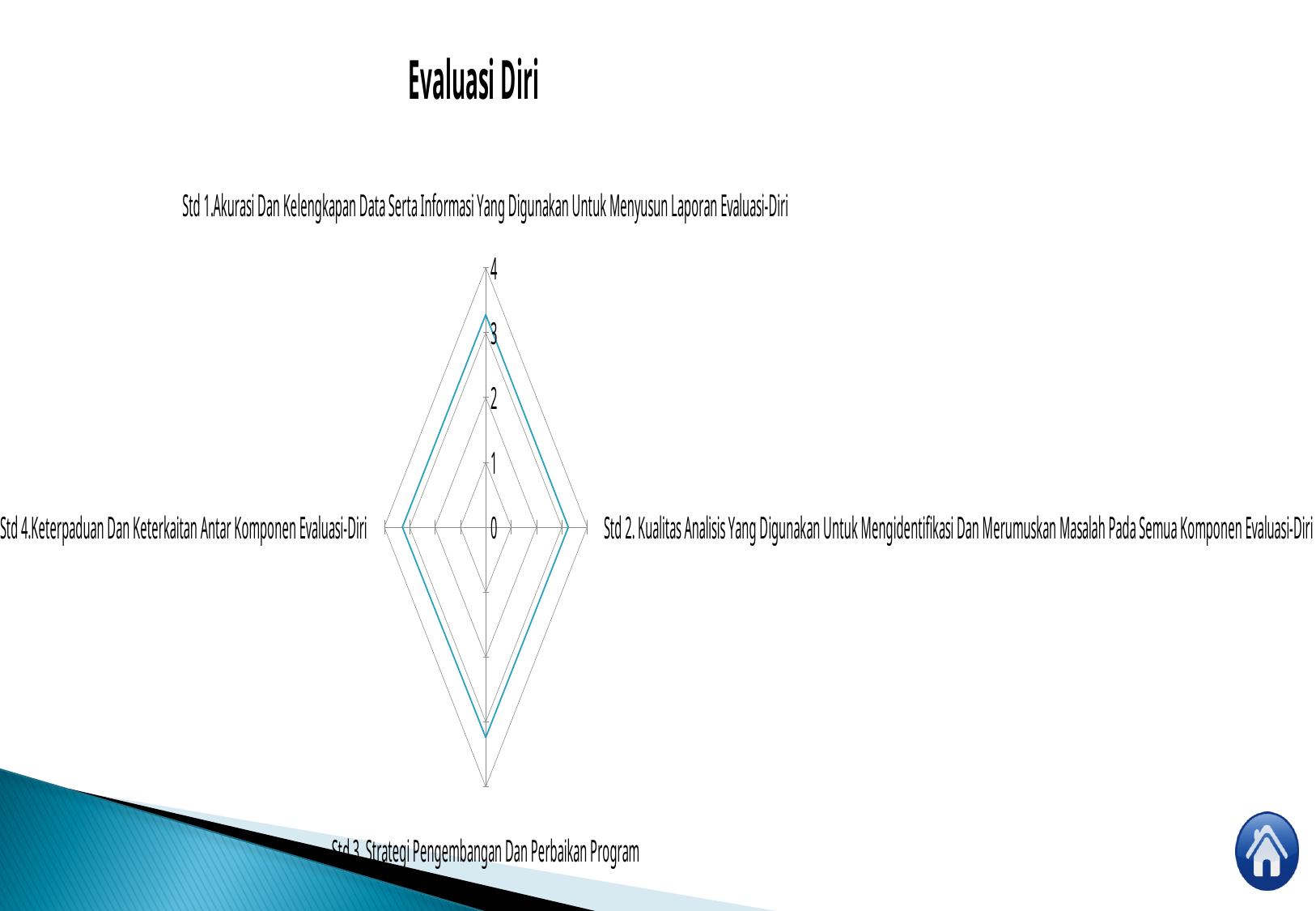
What is the maximum value shown on the radar chart's axis scale? 4 Is the value for Std 4 (Keterpaduan Dan Keterkaitan Antar Komponen Evaluasi-Diri) greater or less than 4? less What kind of chart is shown on the slide? Radar chart Is the value for Std 3 (Strategi Pengembangan Dan Perbaikan Program) greater or less than 2? greater Is the value for Std 4 (Keterpaduan Dan Keterkaitan Antar Komponen Evaluasi-Diri) greater or less than 3? greater What is the title of the slide containing the chart? Evaluasi Diri How many categories (axes) does the radar chart have? 4